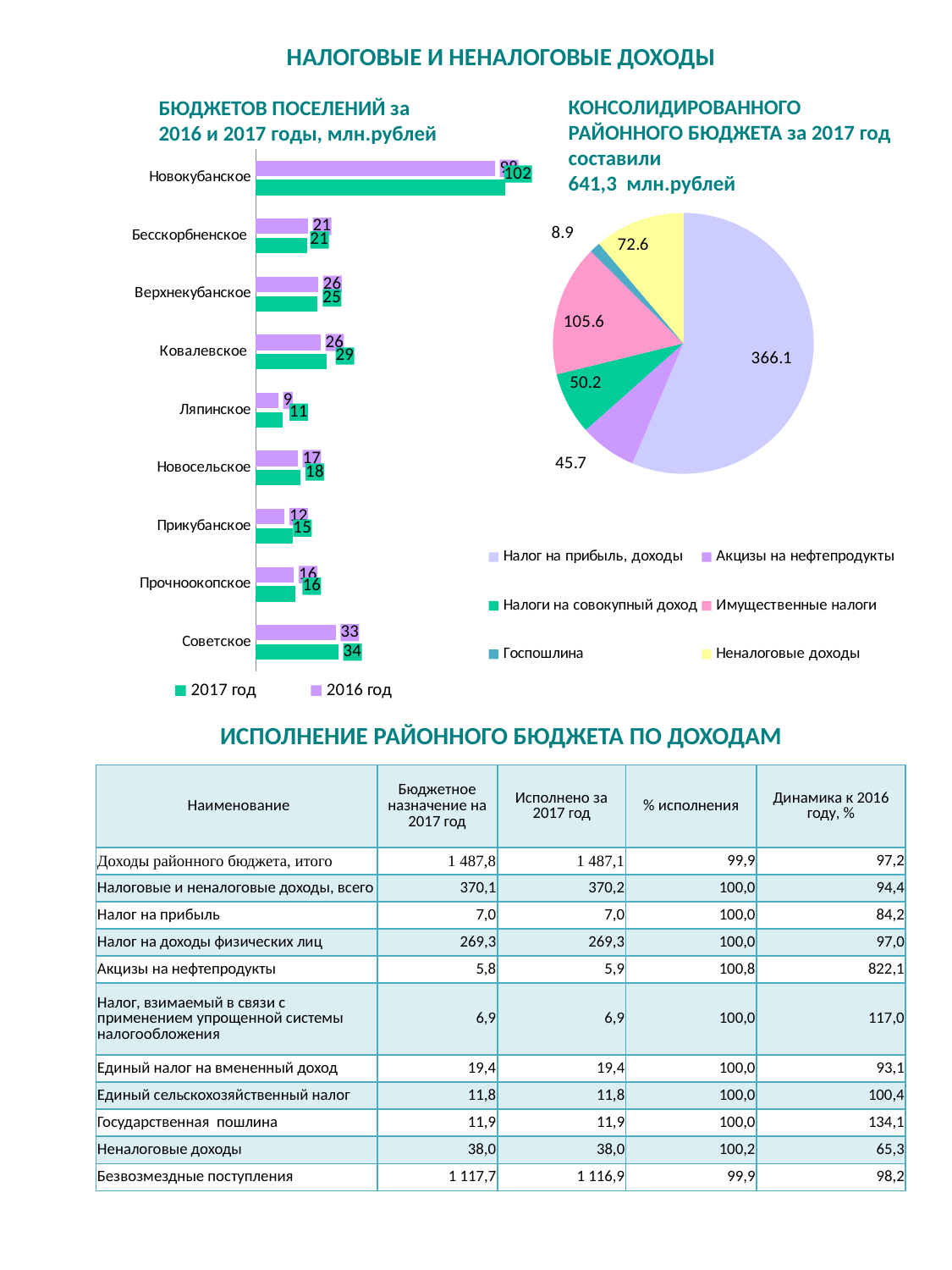
In the bar chart on the left, what is the value for Ляпинское in 2016? 9 How many settlements are shown in the bar chart on the left? 9 In the pie chart on the right, which category has the smallest value? Госпошлина In the bar chart on the left, which settlement has the highest value in 2017? Новокубанское How many series does the legend of the bar chart on the left list? 2 How many categories does the legend of the pie chart on the right list? 6 In the bar chart on the left, what is the value for Советское in 2017? 34 What kind of chart is the chart on the left of the slide? Bar chart In the bar chart on the left, what is the difference between the 2017 and 2016 values for Ковалевское? 3 In the bar chart on the left, which settlement has the lowest value in 2016? Ляпинское In the pie chart on the right, what is the value for Имущественные налоги? 105.6 In the bar chart on the left, which is larger for Верхнекубанское: the 2016 value or the 2017 value? 2016 value